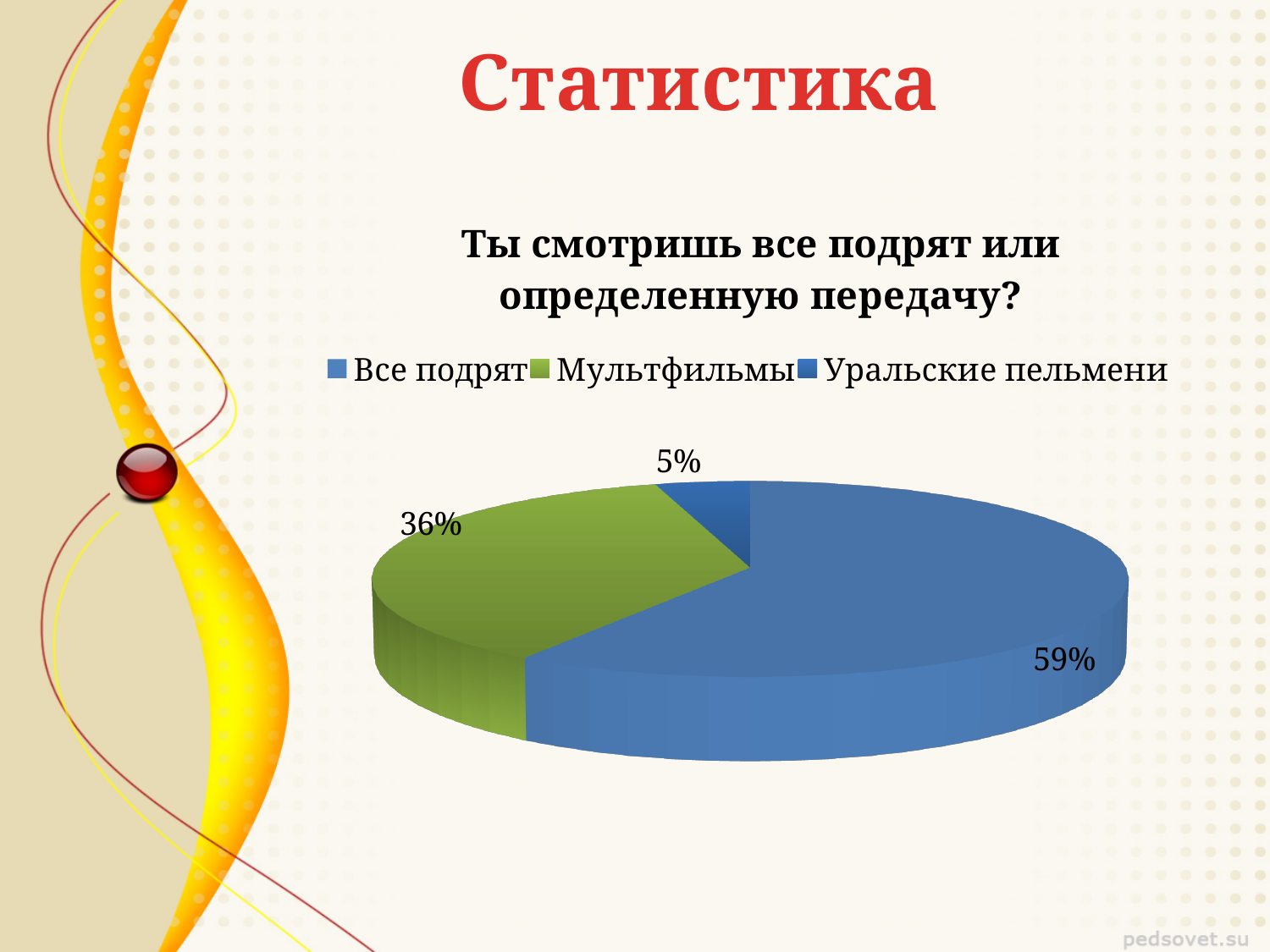
What share of the pie does "Уральские пельмени" have? 5% What is the title of the chart? Ты смотришь все подрят или определенную передачу? Which category has the smallest slice of the pie? Уральские пельмени What share of the pie does "Все подрят" have? 59% What kind of chart is shown on the slide? Pie chart Which is larger: the share for "Мультфильмы" or the share for "Уральские пельмени"? Мультфильмы What is the difference between the shares for "Все подрят" and "Мультфильмы"? 23% Which category has the largest slice of the pie? Все подрят How many entries does the legend list? 3 What share of the pie does "Мультфильмы" have? 36% How many slices does the pie chart have? 3 What is the difference between the shares for "Мультфильмы" and "Уральские пельмени"? 31%